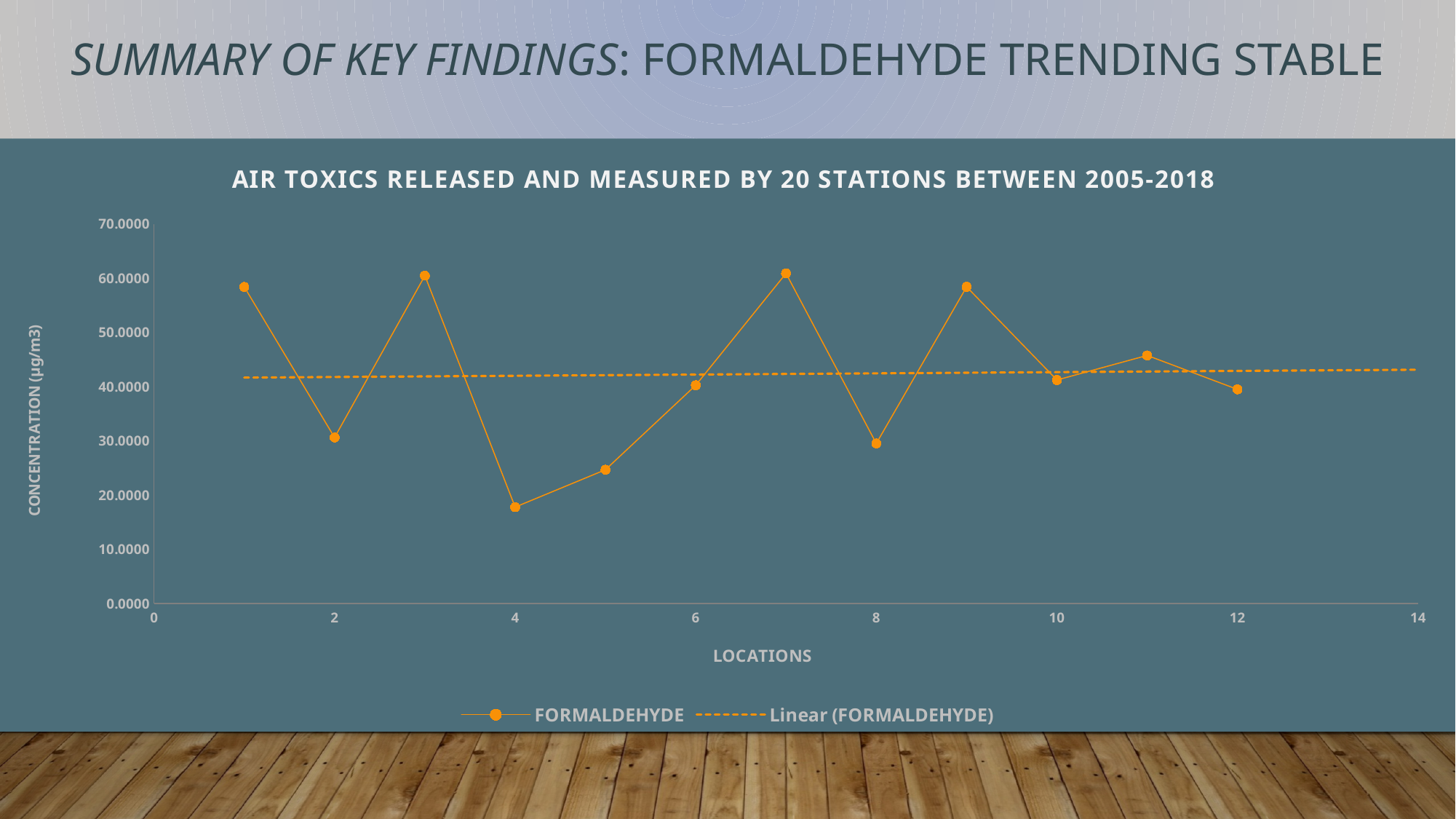
At which location is the Formaldehyde concentration lowest? 4 Which has the higher Formaldehyde concentration, location 4 or location 5? Location 5 Is the Formaldehyde value at location 2 greater or less than 40.0000? less How many data points are plotted for Formaldehyde? 12 What does the dashed line in the chart represent? Linear (FORMALDEHYDE) Which has the higher Formaldehyde concentration, location 1 or location 2? Location 1 What type of chart is shown on the slide? Line chart Is the Formaldehyde value at location 4 greater or less than 20.0000? less How many series does the legend list? 2 What is the title of the chart? Air toxics released and measured by 20 stations between 2005-2018 Is the Formaldehyde value at location 9 greater or less than 50.0000? greater